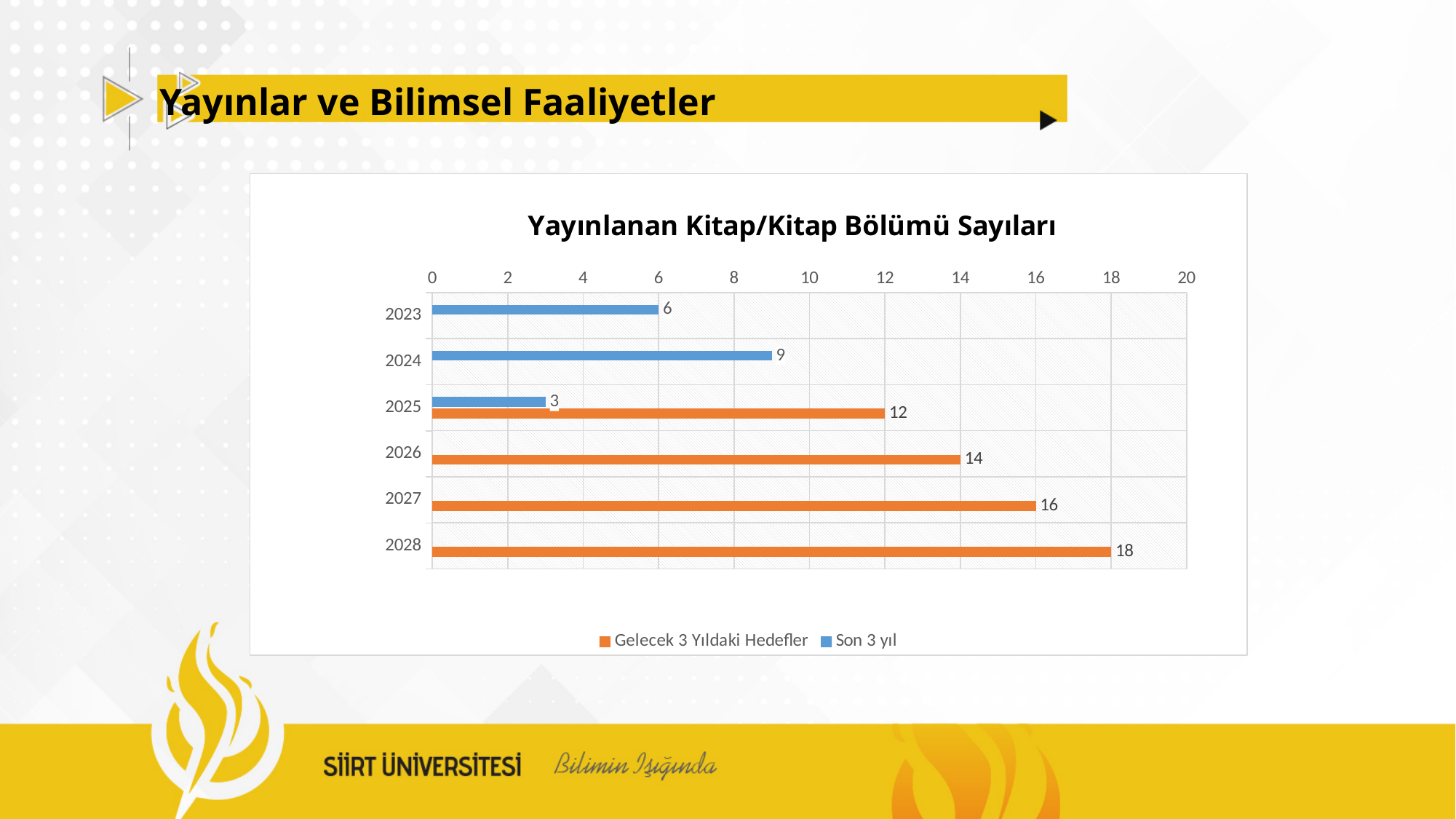
How many series does the legend list? 2 What is the value for 2023 in the Son 3 yıl series? 6 How many years are shown on the vertical axis of the chart? 6 What is the title of the chart? Yayınlanan Kitap/Kitap Bölümü Sayıları What is the Gelecek 3 Yıldaki Hedefler value for 2028? 18 What is the Gelecek 3 Yıldaki Hedefler value for 2025? 12 What is the difference between the Gelecek 3 Yıldaki Hedefler value for 2027 and the value for 2026? 2 What kind of chart is shown on the slide? Bar chart Which year has the lowest value in the Son 3 yıl series? 2025 What is the value for 2024 in the Son 3 yıl series? 9 Which is larger: the Son 3 yıl value for 2024 or the Son 3 yıl value for 2023? 2024 Which year has the highest value in the Gelecek 3 Yıldaki Hedefler series? 2028